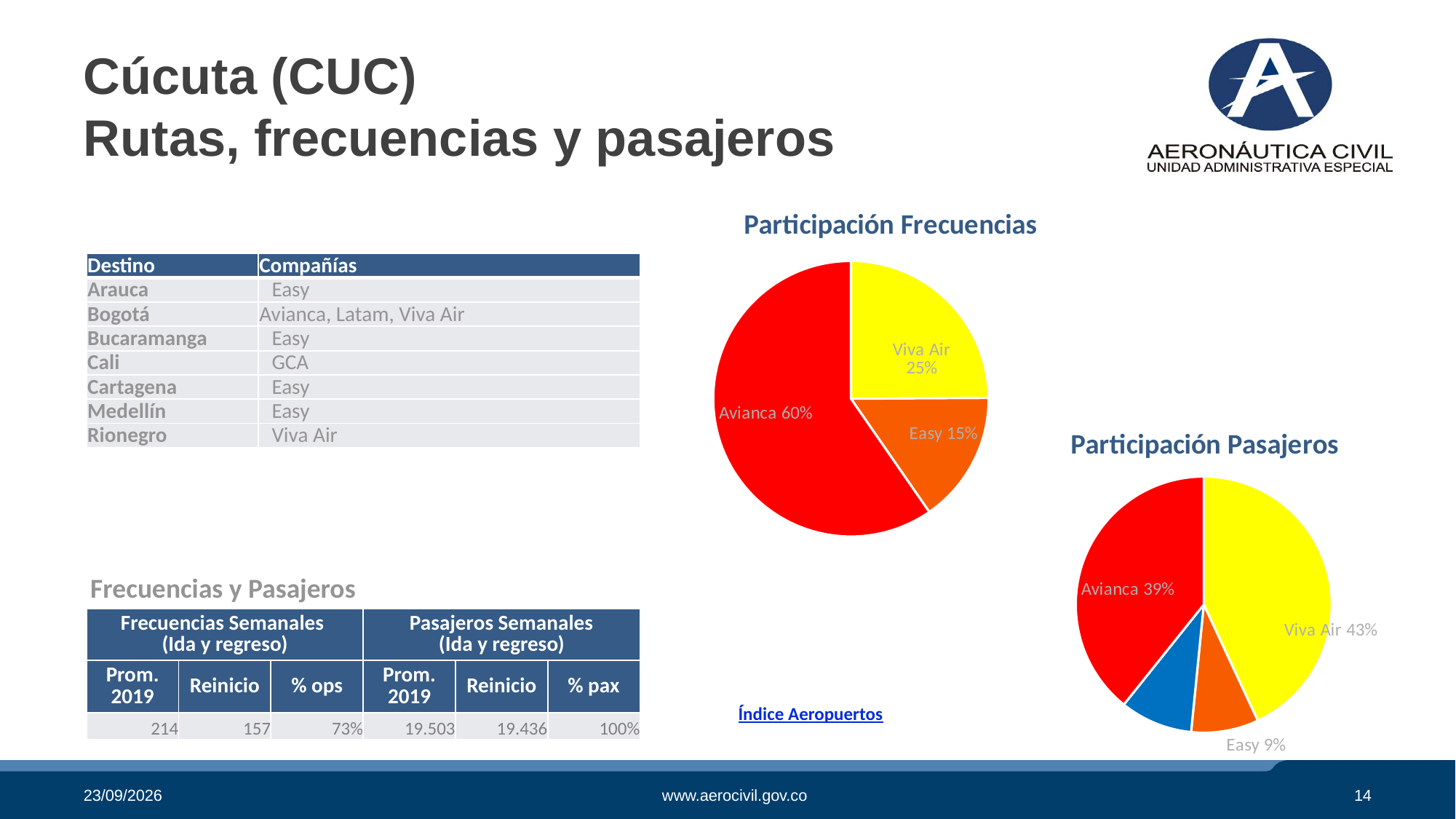
In the 'Participación Frecuencias' pie chart, what share does Avianca have? 60% In the 'Participación Pasajeros' pie chart, what share does Avianca have? 39% In the 'Participación Pasajeros' pie chart, what share does Easy have? 9% In the 'Participación Pasajeros' pie chart, which is larger: Viva Air's share or Avianca's share? Viva Air In the 'Participación Frecuencias' pie chart, how many percentage points larger is Avianca's share than Viva Air's? 35 percentage points In the 'Participación Pasajeros' pie chart, what share does Viva Air have? 43% In the 'Participación Frecuencias' pie chart, which airline has the smallest slice? Easy In the 'Participación Frecuencias' pie chart, what share does Viva Air have? 25% In the 'Participación Pasajeros' pie chart, which labelled airline has the largest share? Viva Air What type of chart is 'Participación Frecuencias'? Pie chart In the 'Participación Frecuencias' pie chart, what share does Easy have? 15% In the 'Participación Frecuencias' pie chart, which airline has the largest slice? Avianca